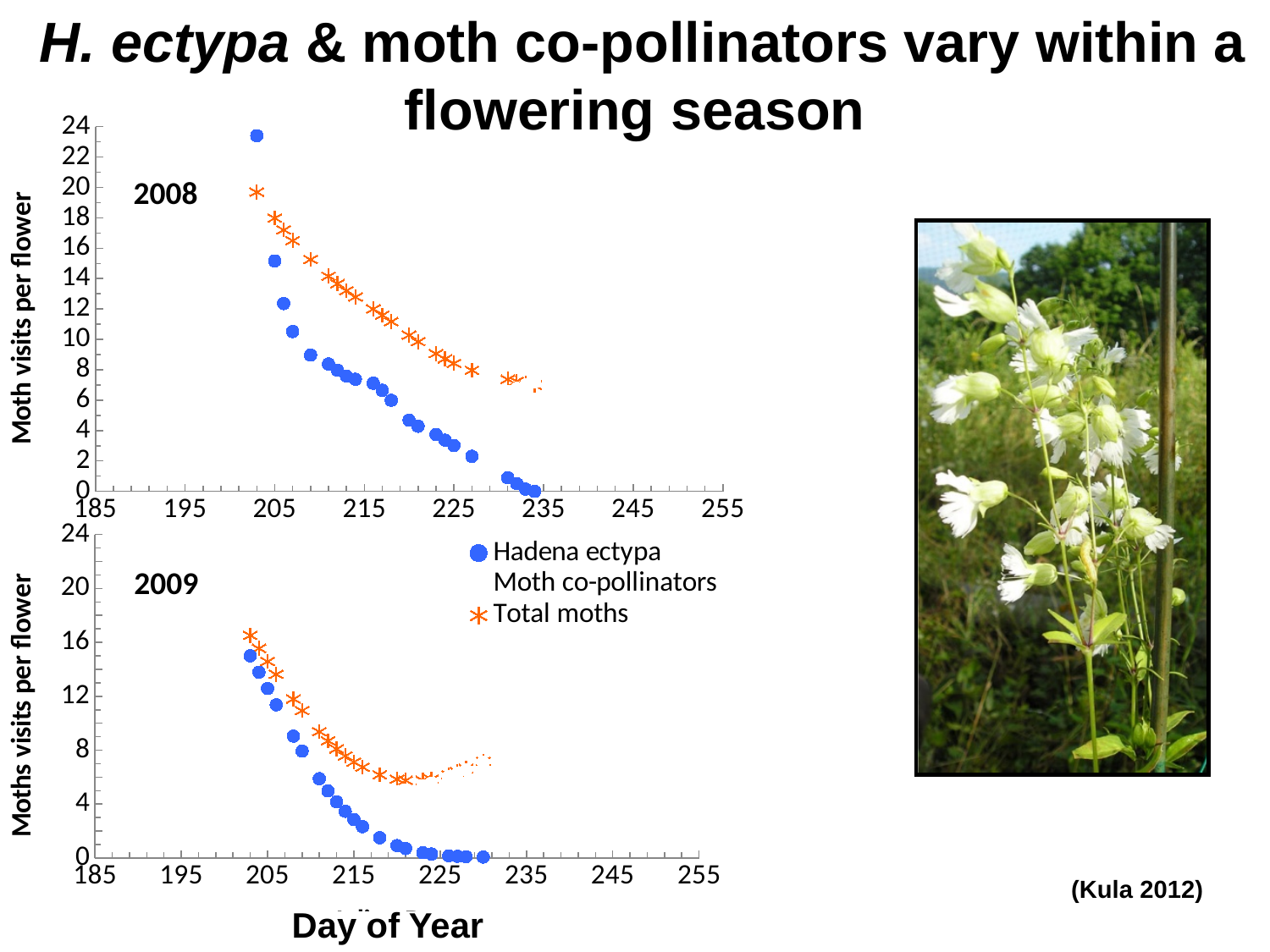
In the top chart (2008), is the Total moths value at day 203 greater or less than 18? greater In the top chart (2008), which series has the higher value at day 215: Hadena ectypa or Total moths? Total moths In the bottom chart (2009), is the Hadena ectypa value at day 225 greater or less than 4? less In the top chart (2008), do the Hadena ectypa values rise or fall as Day of Year increases? Fall In the bottom chart (2009), is the Hadena ectypa value at day 203 greater or less than 12? greater In the bottom chart (2009), do the Total moths values rise or fall from day 203 to day 220? Fall What is the highest tick value on the y axis of the top chart (2008)? 24 What kind of chart is the top chart labelled 2008? Scatter chart In the bottom chart (2009), which series has the higher value at day 215: Hadena ectypa or Total moths? Total moths Which year does the bottom chart show? 2009 What is the x-axis label shared by the two charts? Day of Year